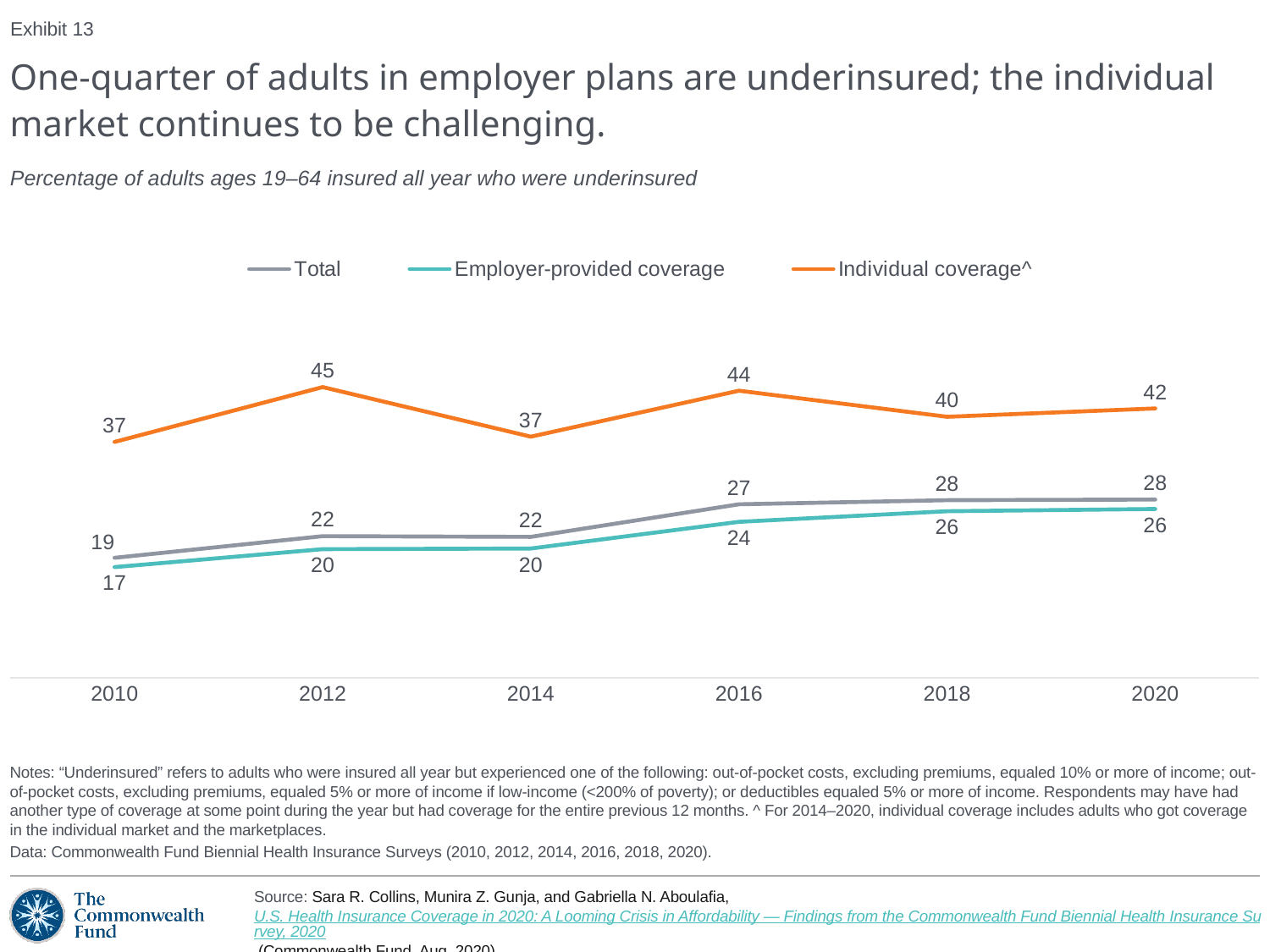
Which is larger in 2014: the Total value or the Employer-provided coverage value? Total What is the difference between Individual coverage^ and Employer-provided coverage in 2020? 16 What is the value for Total in 2016? 27 What colour is the line for Individual coverage^? Orange How many series does the legend list? 3 In which year is the Individual coverage^ value highest? 2012 What is the value for Individual coverage^ in 2012? 45 In which year is the Employer-provided coverage value lowest? 2010 What is the value for Employer-provided coverage in 2010? 17 Does the Employer-provided coverage series rise or fall from 2010 to 2020? Rise How many years are shown on the x axis? 6 What kind of chart is shown on the slide? Line chart